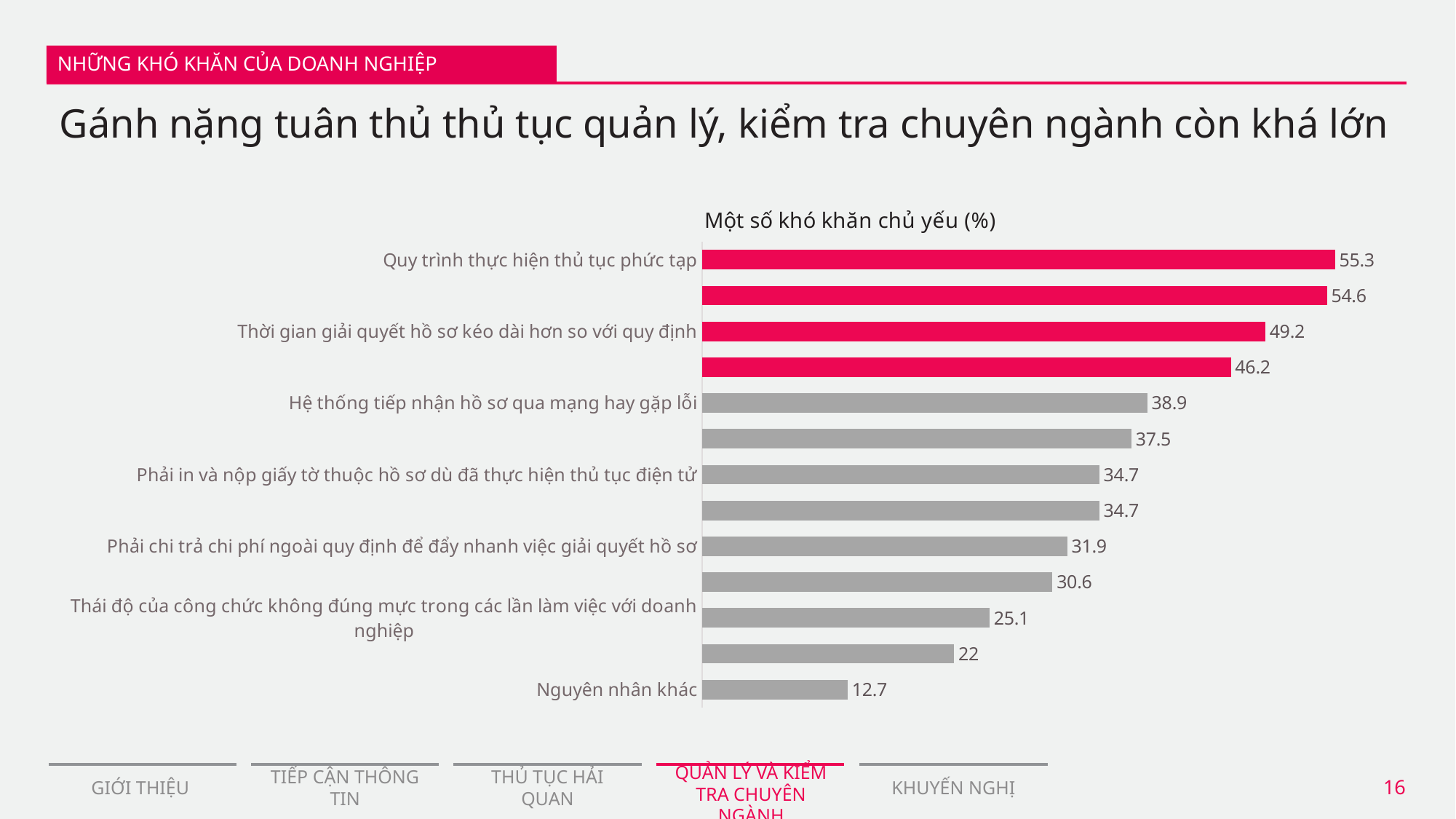
What is the difference between the values for "Quy trình thực hiện thủ tục phức tạp" and "Thời gian giải quyết hồ sơ kéo dài hơn so với quy định"? 6.1 Which category has the lowest value in the chart? Nguyên nhân khác What is the value for "Nguyên nhân khác"? 12.7 What is the value for "Thời gian giải quyết hồ sơ kéo dài hơn so với quy định"? 49.2 Which is larger: the value for "Hệ thống tiếp nhận hồ sơ qua mạng hay gặp lỗi" or the value for "Thái độ của công chức không đúng mực trong các lần làm việc với doanh nghiệp"? Hệ thống tiếp nhận hồ sơ qua mạng hay gặp lỗi How many bars are plotted in the chart? 13 What is the value for "Quy trình thực hiện thủ tục phức tạp"? 55.3 What type of chart is shown on the slide? bar chart What is the title of the chart? Một số khó khăn chủ yếu (%) What is the value for "Hệ thống tiếp nhận hồ sơ qua mạng hay gặp lỗi"? 38.9 What is the value for "Phải chi trả chi phí ngoài quy định để đẩy nhanh việc giải quyết hồ sơ"? 31.9 Which category has the highest value in the chart? Quy trình thực hiện thủ tục phức tạp